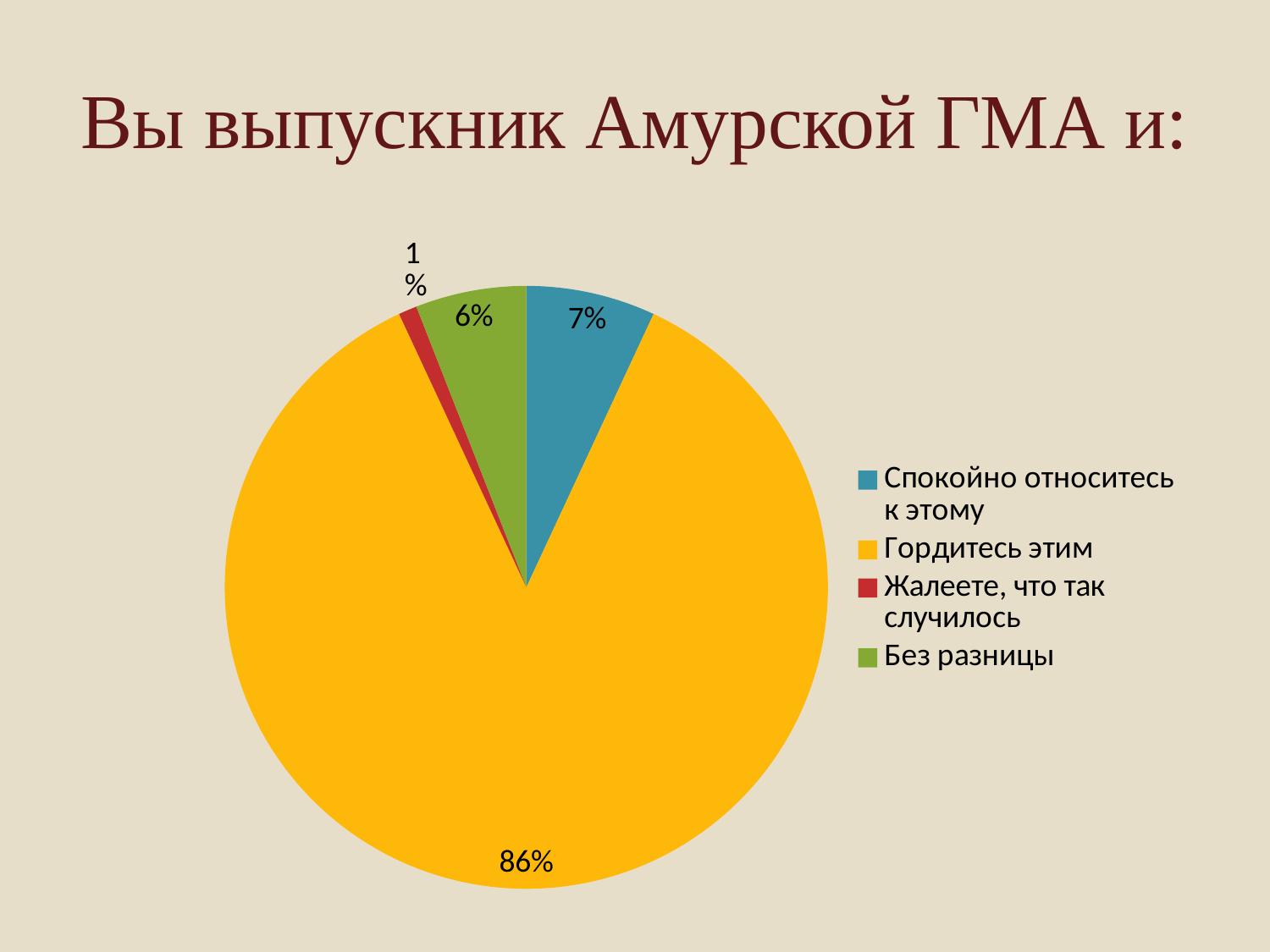
Which is larger: the slice for "Спокойно относитесь к этому" or the slice for "Без разницы"? Спокойно относитесь к этому What share of the pie is labelled "Жалеете, что так случилось"? 1% Which category has the smallest slice of the pie? Жалеете, что так случилось What is the difference in percentage points between "Гордитесь этим" and "Спокойно относитесь к этому"? 79 Which category has the largest slice of the pie? Гордитесь этим What share of the pie is labelled "Спокойно относитесь к этому"? 7% What is the title of the slide? Вы выпускник Амурской ГМА и: How many categories does the legend list? 4 What colour is the slice for "Без разницы"? green What share of the pie is labelled "Гордитесь этим"? 86% What kind of chart is shown on the slide? pie chart